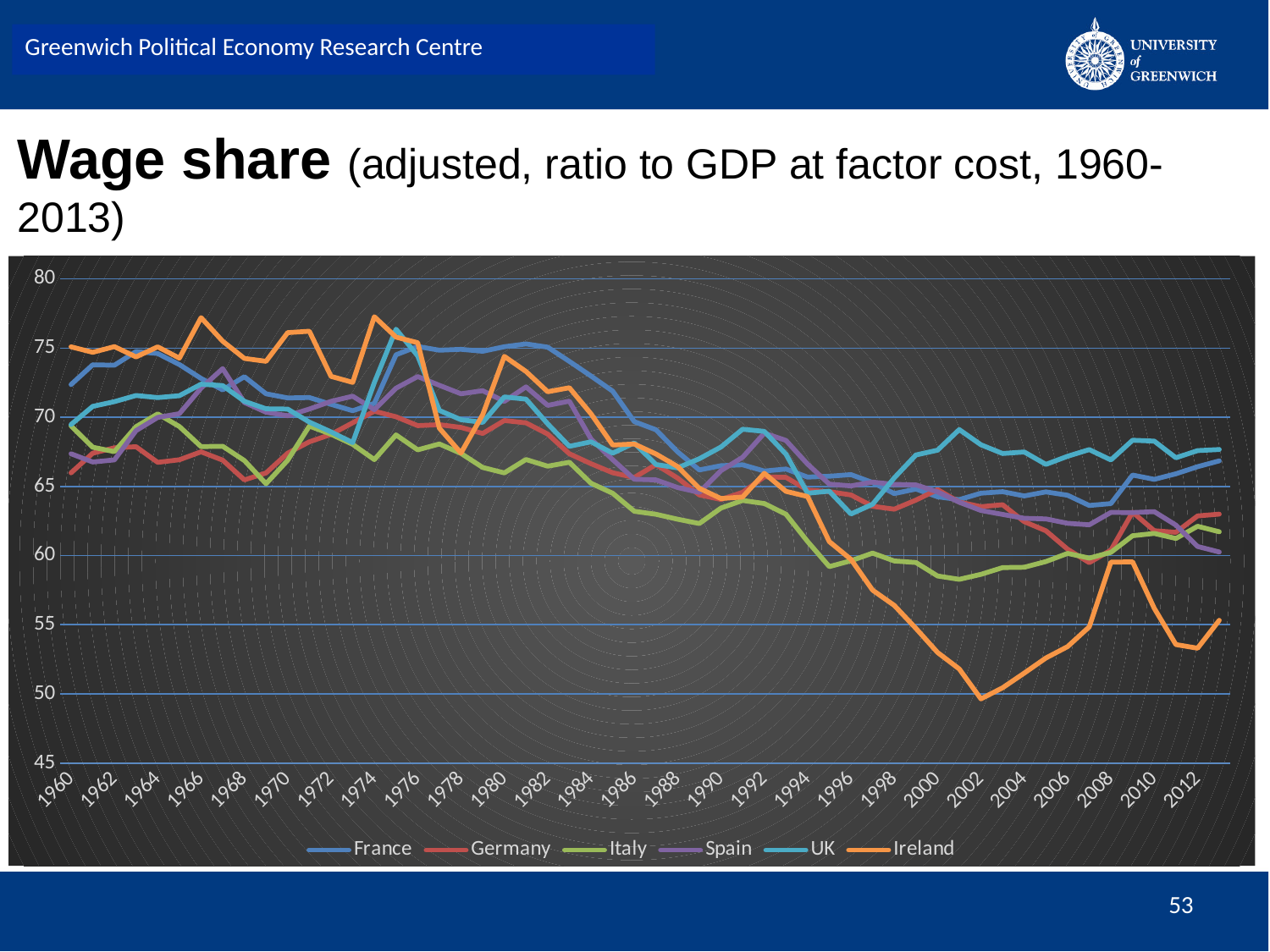
In 2012, which series has the higher value, UK or Ireland? UK Which countries are listed in the chart legend? France, Germany, Italy, Spain, UK, Ireland Which series reaches the lowest value anywhere on the chart? Ireland Does the wage share for Ireland rise or fall between 2002 and 2008? rise Does the wage share for France rise or fall between 1982 and 2013? fall Is the value for Ireland in 2002 greater or less than 55? less Is the value for Italy in 2002 greater or less than 60? less Is the value for Ireland in 1966 greater or less than 75? greater What is the title of the chart on the slide? Wage share (adjusted, ratio to GDP at factor cost, 1960-2013) How many series does the legend list? 6 What kind of chart is shown on the slide? line chart